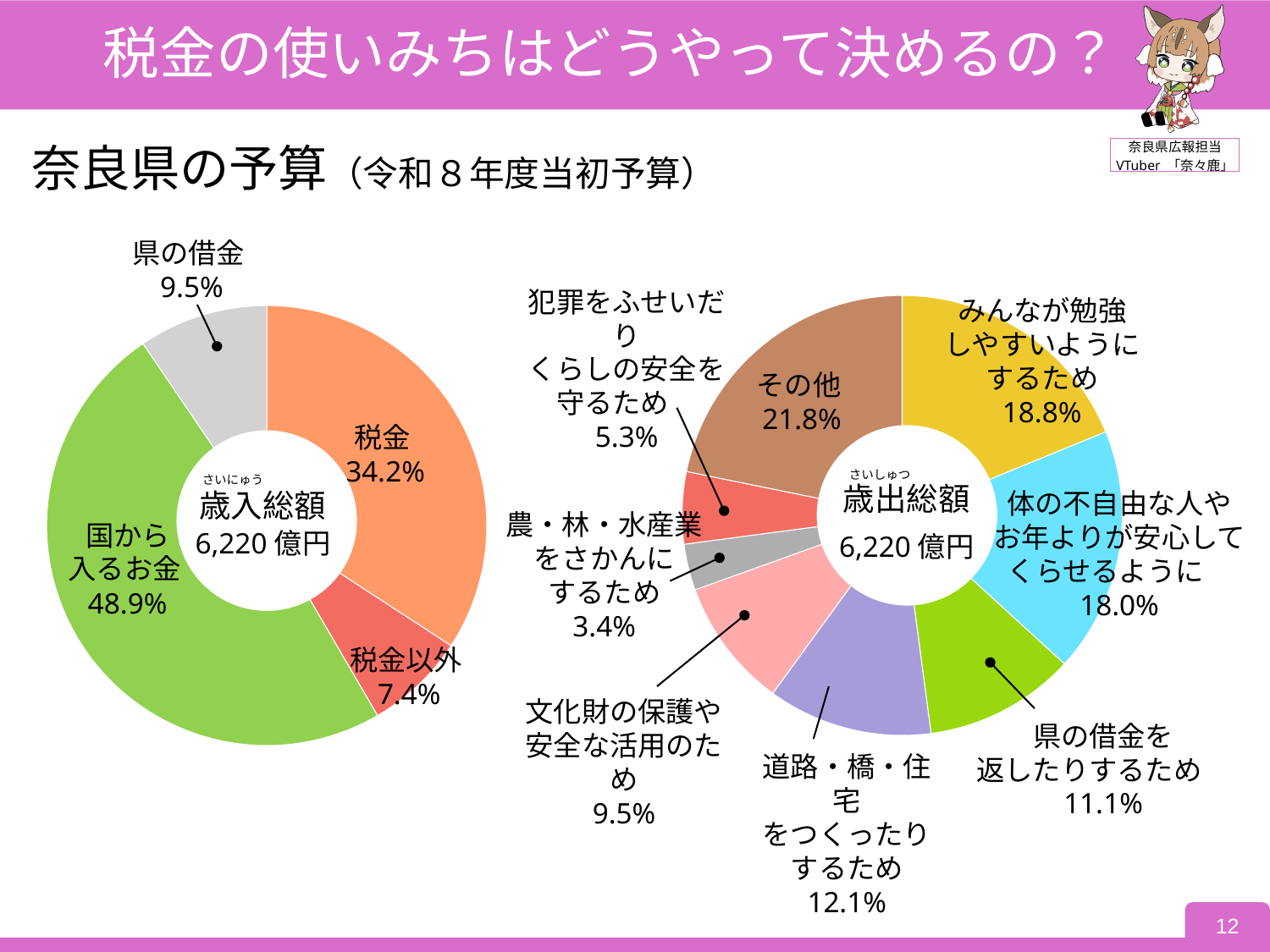
In the right chart (歳出総額), which category has the smallest share? 農・林・水産業をさかんにするため In the left chart (歳入総額), what is the difference in percentage points between 国から入るお金 and 税金? 14.7 In the left chart (歳入総額), how many categories are shown? 4 In the left chart (歳入総額), what share is 税金? 34.2% In the right chart (歳出総額), what share is その他? 21.8% In the left chart (歳入総額), what share is 県の借金? 9.5% In the right chart (歳出総額), which is larger: 県の借金を返したりするため or 文化財の保護や安全な活用のため? 県の借金を返したりするため In the right chart (歳出総額), what share is 道路・橋・住宅をつくったりするため? 12.1% In the left chart (歳入総額), which category has the largest share? 国から入るお金 In the left chart (歳入総額), which category has the smallest share? 税金以外 What kind of chart is used on this slide? Pie (donut) chart In the right chart (歳出総額), how many categories are shown? 8